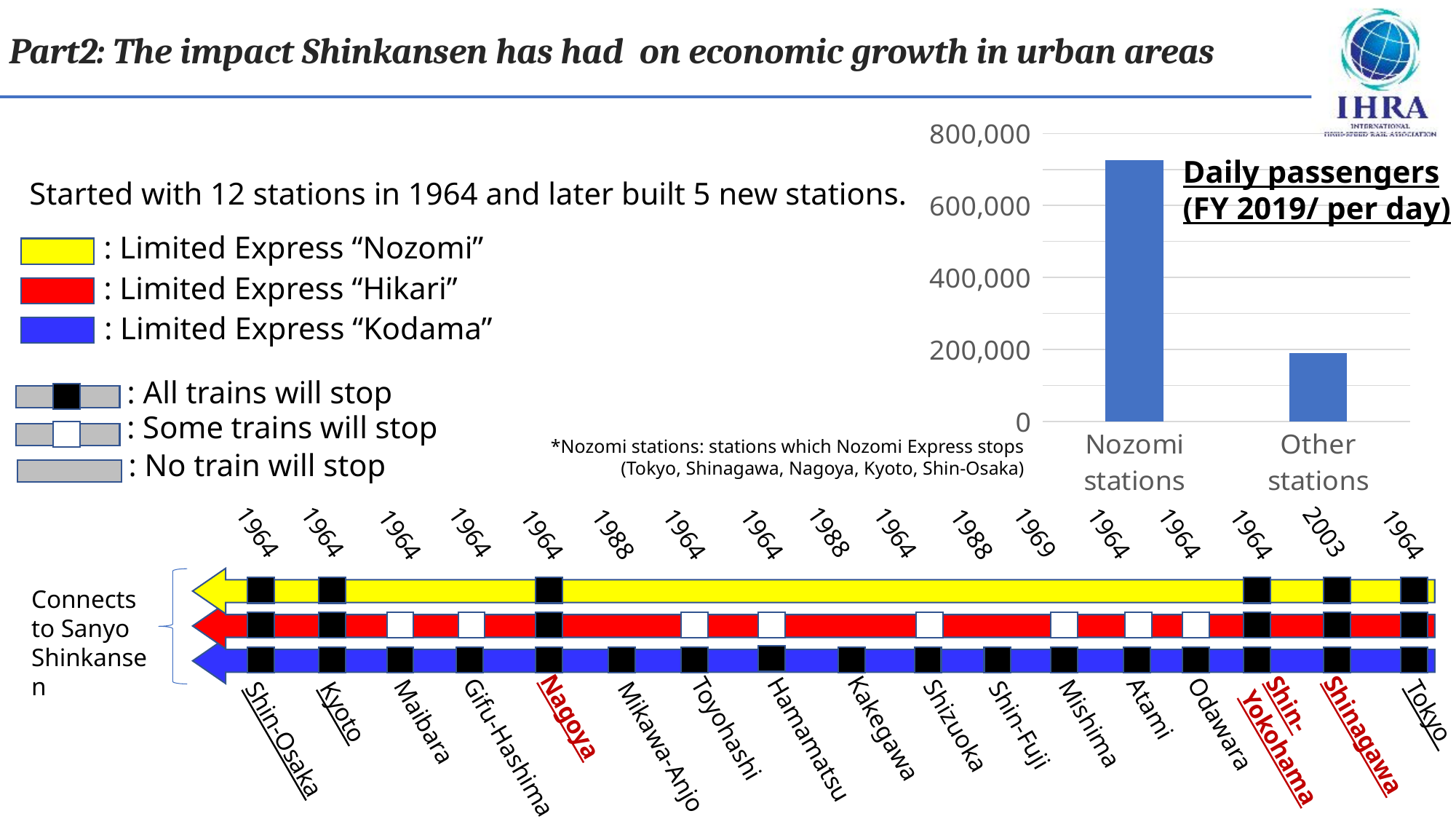
What is the highest value shown on the vertical axis of the 'Daily passengers (FY 2019/ per day)' chart? 800,000 What kind of chart is the 'Daily passengers (FY 2019/ per day)' chart? bar chart Which category has the lowest value on the 'Daily passengers (FY 2019/ per day)' chart? Other stations On the 'Daily passengers (FY 2019/ per day)' chart, which is larger: Nozomi stations or Other stations? Nozomi stations On the 'Daily passengers (FY 2019/ per day)' chart, is the value for Other stations greater or less than 100,000? greater On the 'Daily passengers (FY 2019/ per day)' chart, is the value for Other stations greater or less than 400,000? less Which category has the highest value on the 'Daily passengers (FY 2019/ per day)' chart? Nozomi stations On the 'Daily passengers (FY 2019/ per day)' chart, is the value for Nozomi stations greater or less than 800,000? less How many categories are shown on the 'Daily passengers (FY 2019/ per day)' chart? 2 What is the title of the bar chart on the slide? Daily passengers (FY 2019/ per day)